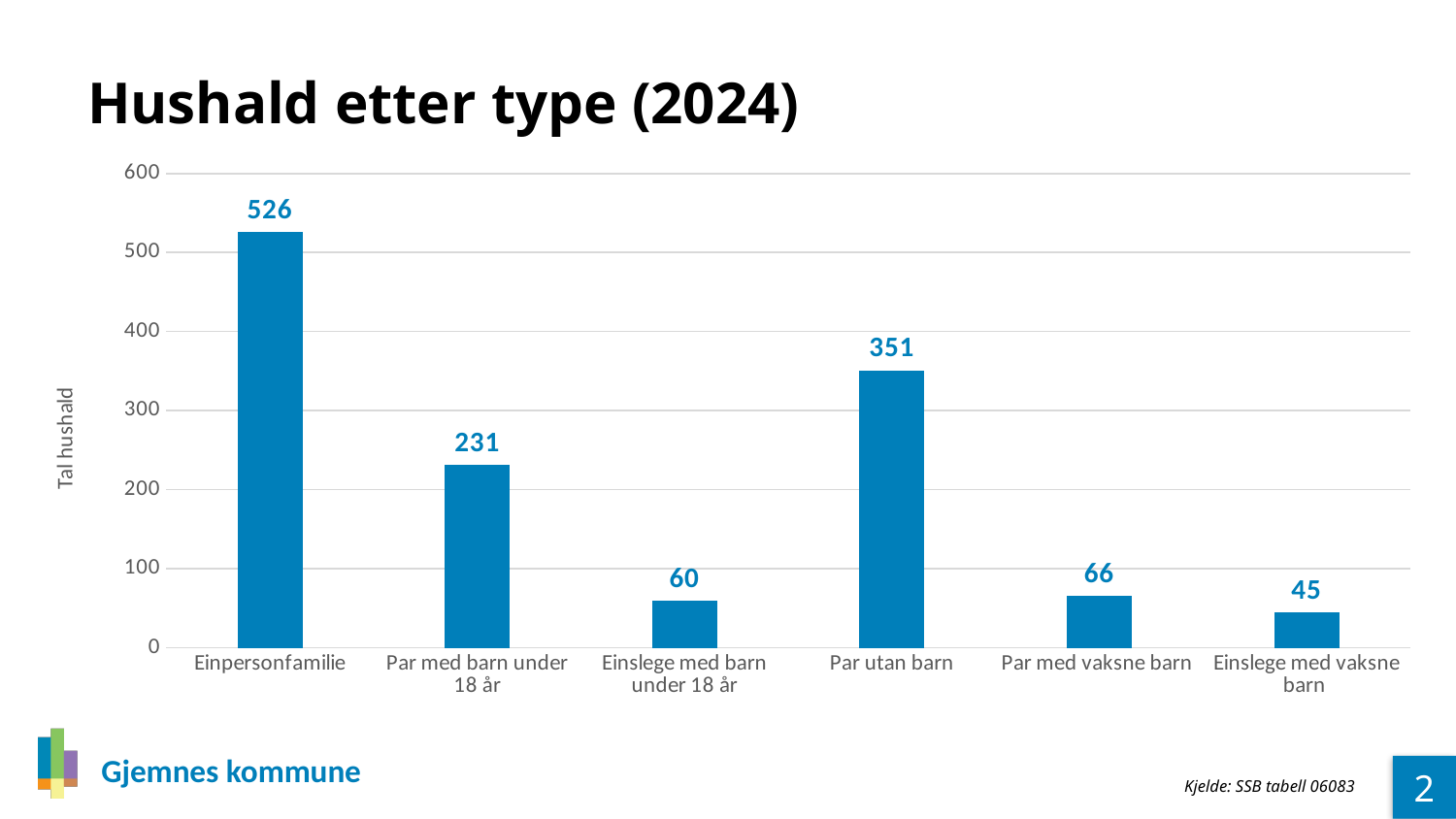
Is the value for Par med barn under 18 år greater or less than 200? greater Which household type has the highest value? Einpersonfamilie What is the difference between Einpersonfamilie and Par utan barn? 175 How many household types are shown in the chart? 6 What is the title of the chart? Hushald etter type (2024) What is the value for Einpersonfamilie? 526 What is the value for Einslege med vaksne barn? 45 What is the value for Par utan barn? 351 Which is larger, Par med barn under 18 år or Par utan barn? Par utan barn What kind of chart is shown on the slide? Bar chart What is the difference between Par med vaksne barn and Einslege med barn under 18 år? 6 Which household type has the lowest value? Einslege med vaksne barn